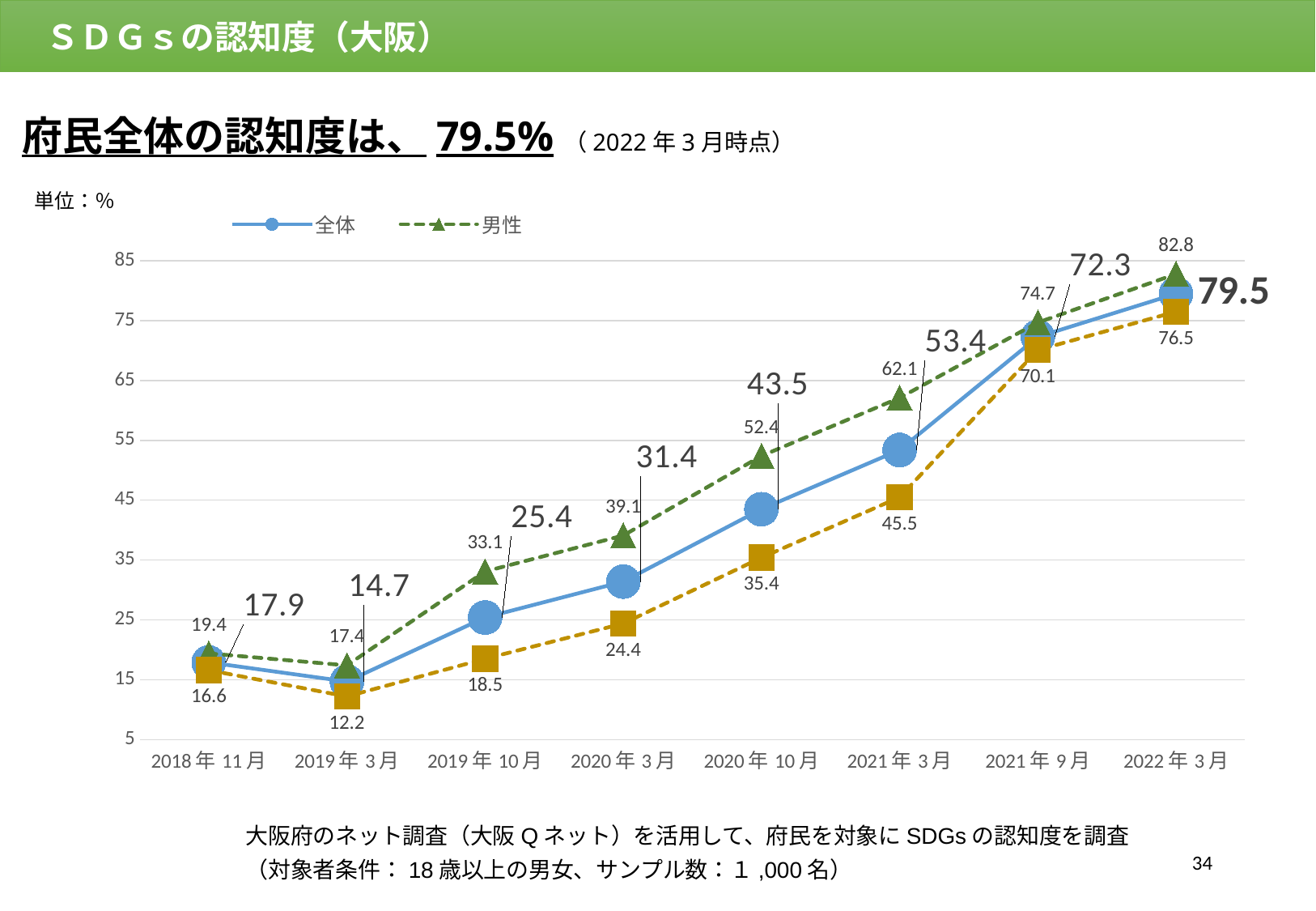
In which period is the 男性 series at its highest? 2022年3月 Does the 全体 series rise or fall from 2019年3月 to 2022年3月? Rise How many series does the legend list? 2 What is the difference between the 男性 and 全体 values in 2021年3月? 8.7 Which is larger in 2020年3月, the 全体 value or the 男性 value? 男性 How many time points are plotted on the x axis? 8 What is the value for 全体 in 2019年3月? 14.7 What is the value for 男性 in 2020年10月? 52.4 What is the value for 男性 in 2018年11月? 19.4 What kind of chart is shown on the slide? Line chart In which period is the 全体 series at its lowest? 2019年3月 What is the value for 全体 in 2022年3月? 79.5